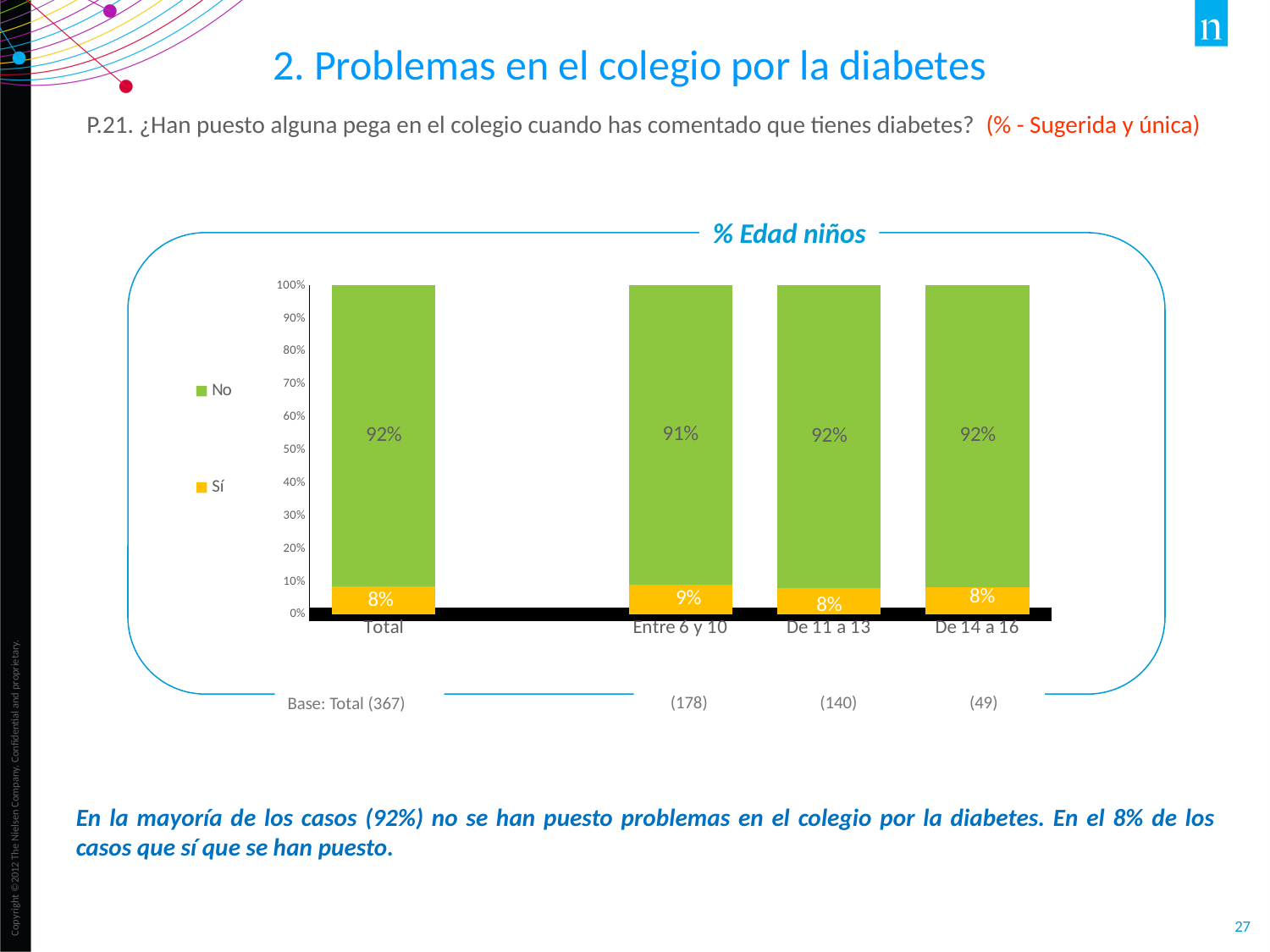
Which is larger: the "Sí" value for "Entre 6 y 10" or the "Sí" value for "De 11 a 13"? Entre 6 y 10 What is the value for "No" in the "De 11 a 13" category? 92% Which category has the highest value for "Sí"? Entre 6 y 10 What is the difference between the "No" value for Total and the "No" value for "Entre 6 y 10"? 1% How many series does the legend list? 2 What is the value for "Sí" in the "De 14 a 16" category? 8% What is the value for "Sí" in the "Entre 6 y 10" category? 9% What kind of chart is shown on the slide? Stacked bar chart What is the value for "No" in the Total category? 92% Which category has the lowest value for "No"? Entre 6 y 10 What is the total of the stacked bar for "Entre 6 y 10"? 100% How many categories are shown on the x axis? 4